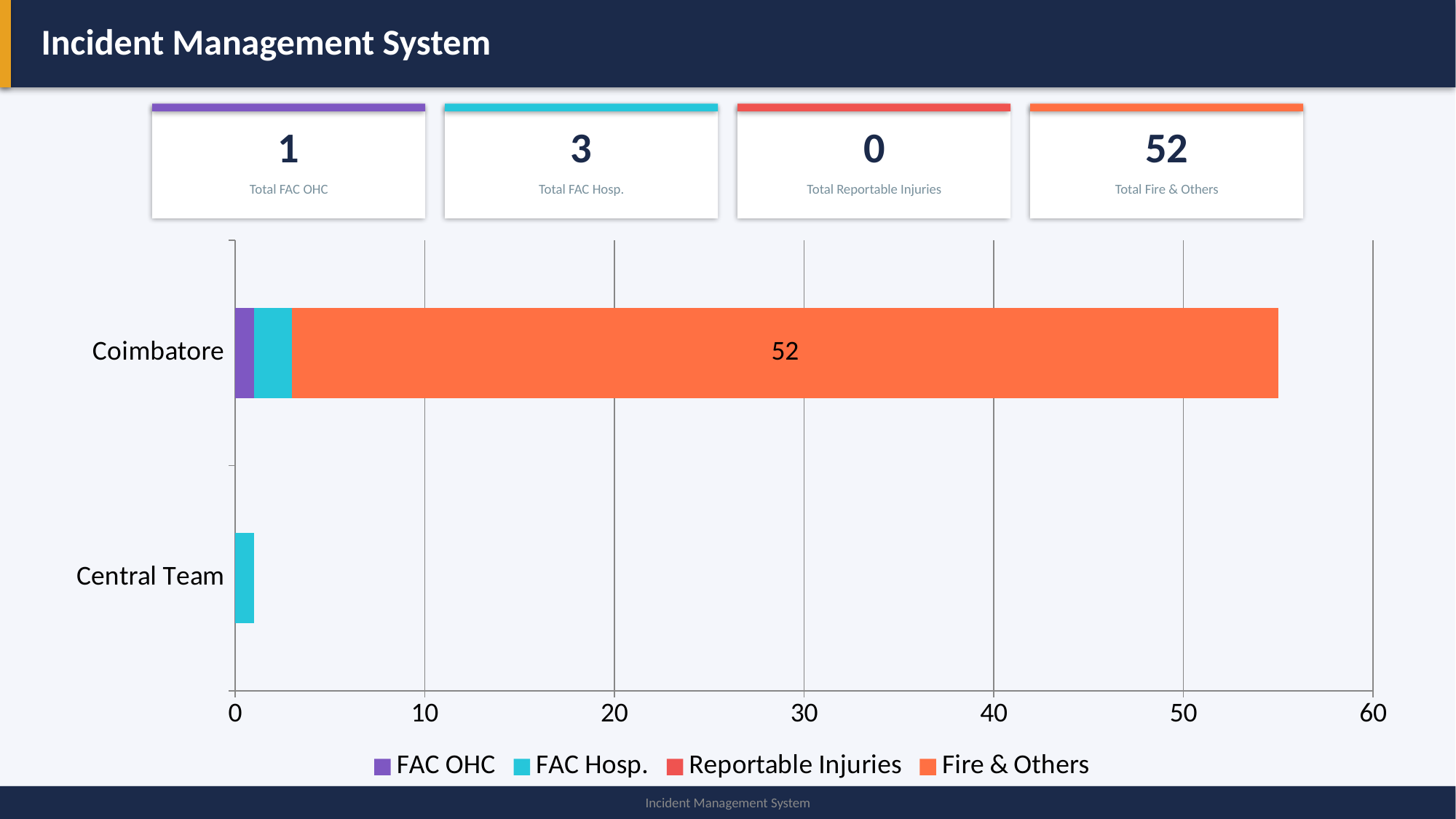
Which category has the shortest stacked bar? Central Team What is the Fire & Others value for Coimbatore? 52 What is the highest value shown on the horizontal axis? 60 How many categories are shown on the vertical axis of the chart? 2 Is the total stacked bar for Central Team greater or less than 10? less How many series does the chart legend list? 4 Which series is the only one visible in the Central Team bar? FAC Hosp. What kind of chart is shown on the slide? bar chart Which has the larger total bar, Coimbatore or Central Team? Coimbatore Which category has the longest stacked bar? Coimbatore Is the total stacked bar for Coimbatore greater or less than 50? greater